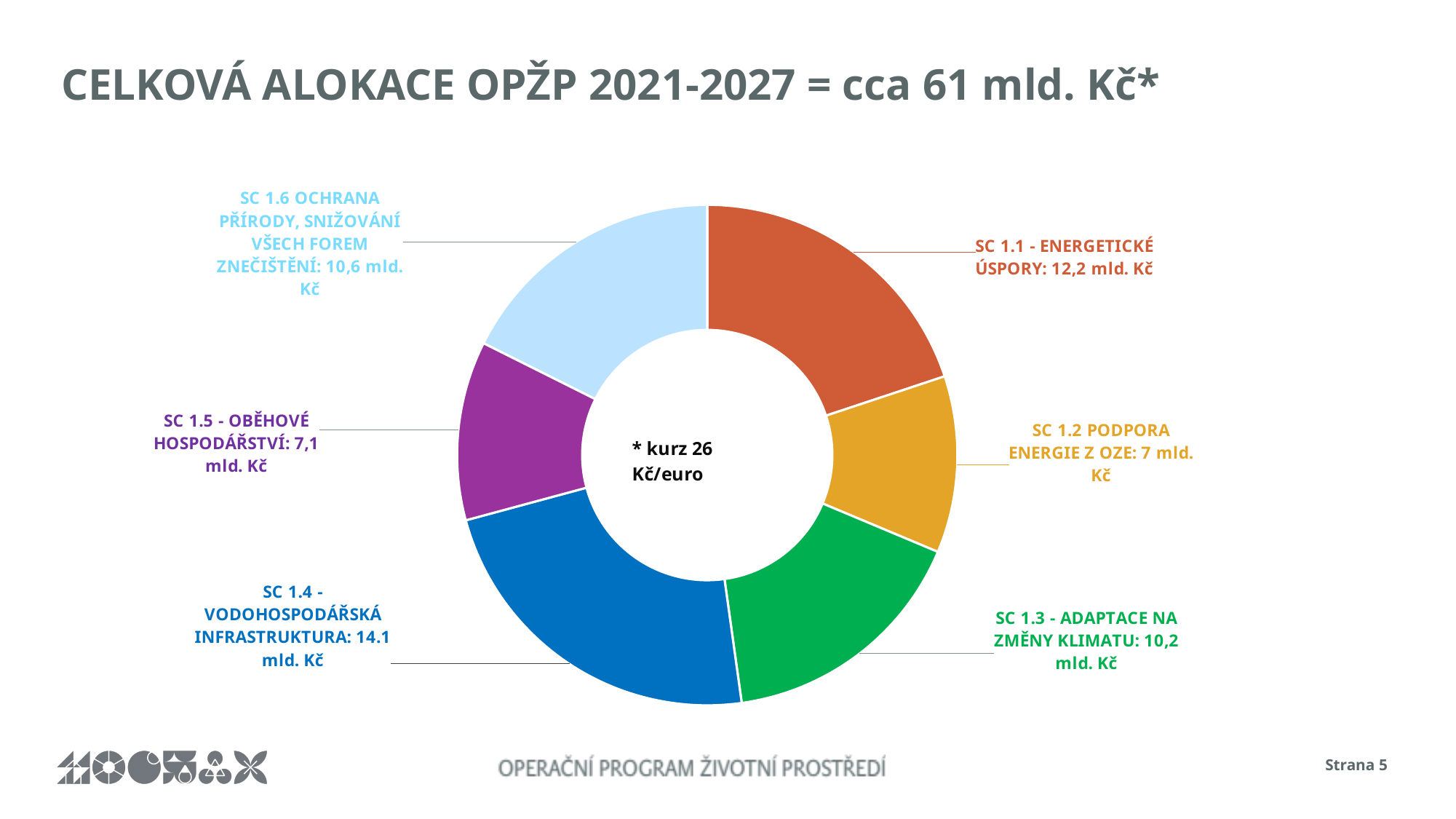
What is the allocation for SC 1.2 PODPORA ENERGIE Z OZE? 7 mld. Kč What is the allocation for SC 1.4 - VODOHOSPODÁŘSKÁ INFRASTRUKTURA? 14.1 mld. Kč Which specific objective (SC) has the largest allocation? SC 1.4 - VODOHOSPODÁŘSKÁ INFRASTRUKTURA Which specific objective (SC) has the smallest allocation? SC 1.2 PODPORA ENERGIE Z OZE What is the difference between the allocations for SC 1.6 and SC 1.3? 0,4 mld. Kč What is the allocation for SC 1.6 OCHRANA PŘÍRODY, SNIŽOVÁNÍ VŠECH FOREM ZNEČIŠTĚNÍ? 10,6 mld. Kč How many specific objectives (slices) are shown in the chart? 6 What is the difference between the allocations for SC 1.4 and SC 1.1? 1,9 mld. Kč Which has a larger allocation, SC 1.1 - ENERGETICKÉ ÚSPORY or SC 1.3 - ADAPTACE NA ZMĚNY KLIMATU? SC 1.1 - ENERGETICKÉ ÚSPORY What kind of chart is shown on the slide? Doughnut (pie) chart What exchange rate is noted in the centre of the chart? 26 Kč/euro What is the allocation for SC 1.1 - ENERGETICKÉ ÚSPORY? 12,2 mld. Kč